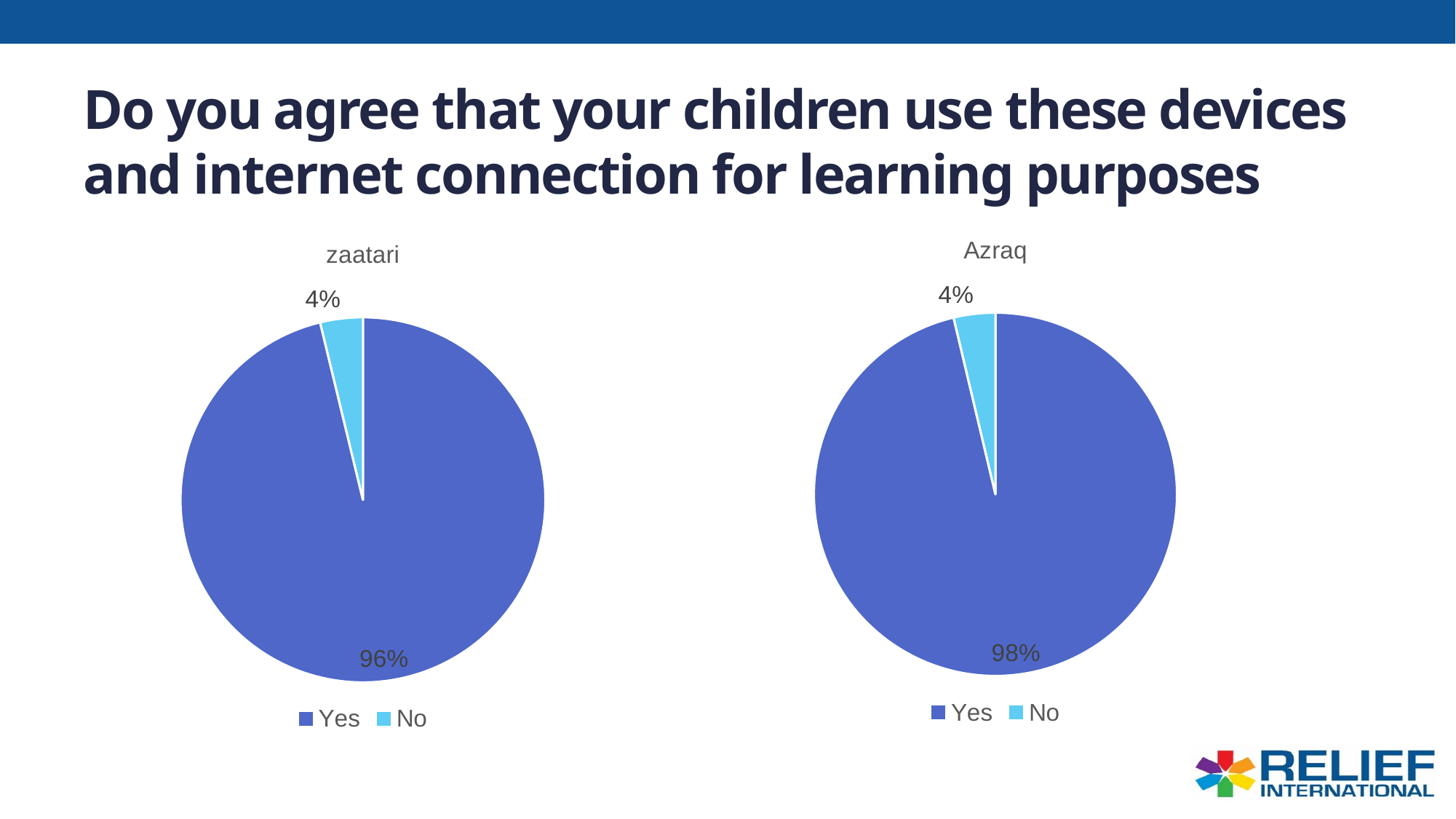
Is the Yes share larger in the zaatari chart or the Azraq chart? Azraq In the Azraq pie chart, what percentage answered No? 4% In the zaatari pie chart, what is the difference between the Yes and No shares? 92% In the zaatari pie chart, what percentage answered Yes? 96% In the zaatari pie chart, what percentage answered No? 4% What type of chart is used for the Azraq data? Pie chart How many slices does the zaatari pie chart have? 2 In the Azraq pie chart, which response has the smallest share? No In the zaatari chart, what colour is the No slice? Light blue How many entries does the legend of the Azraq chart list? 2 In the Azraq pie chart, what percentage answered Yes? 98% In the zaatari pie chart, which response has the largest share? Yes